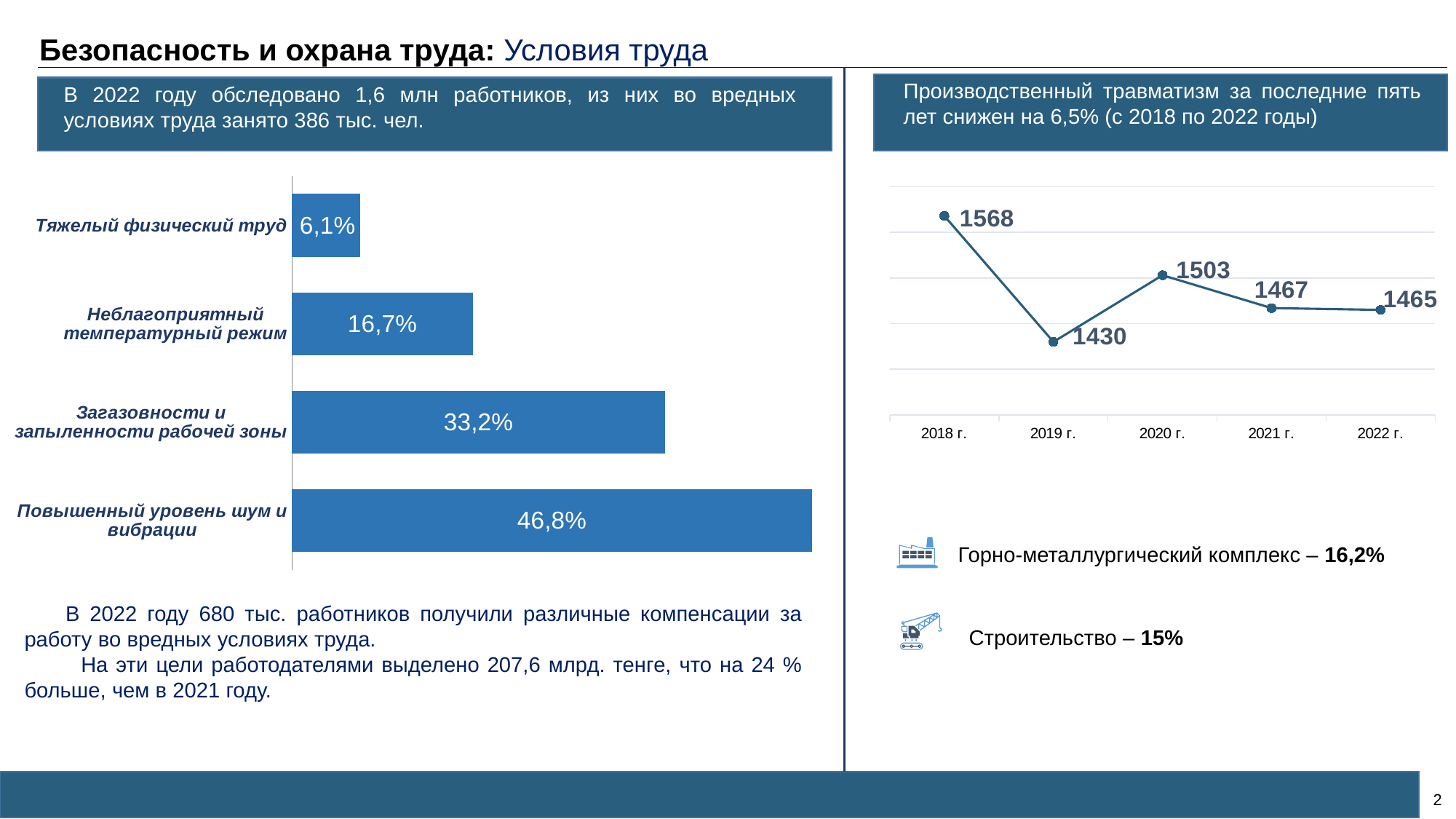
On the right line chart, what is the value for 2019 г.? 1430 On the left bar chart, what is the value for Повышенный уровень шум и вибрации? 46,8% On the left bar chart, how many categories are shown? 4 On the right line chart, which year has the highest value? 2018 г. On the right line chart, which is larger: the value for 2020 г. or 2021 г.? 2020 г. What kind of chart is on the left side of the slide? bar chart On the left bar chart, what is the difference between Загазовности и запыленности рабочей зоны and Тяжелый физический труд? 27,1% On the left bar chart, which category has the lowest value? Тяжелый физический труд On the right line chart, what is the difference between the 2018 г. and 2022 г. values? 103 On the right line chart, what is the value for 2022 г.? 1465 On the left bar chart, what is the value for Неблагоприятный температурный режим? 16,7% On the left bar chart, which category has the highest value? Повышенный уровень шум и вибрации